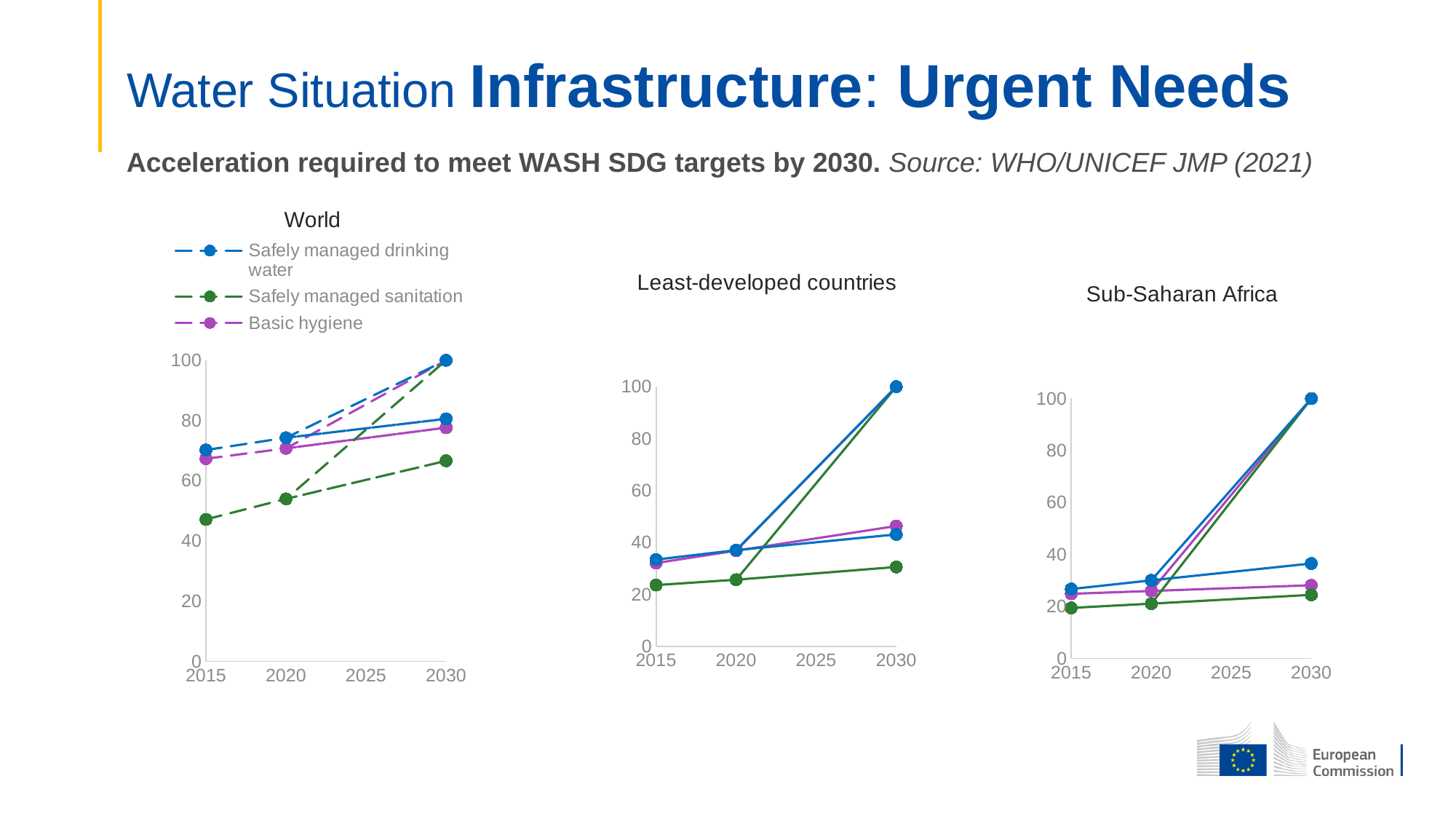
In the Least-developed countries chart, is the value for Safely managed sanitation in 2015 greater or less than 40? less In the Least-developed countries chart, what value do the steeply rising lines reach in 2030? 100 In the World chart, does the Safely managed sanitation line rise or fall from 2015 to 2030? rise What kind of chart is the World chart? line chart In the World chart, which is larger in 2015: Safely managed drinking water or Safely managed sanitation? Safely managed drinking water In the World chart legend, what colour is the Basic hygiene series? purple In the Sub-Saharan Africa chart, is the value for Safely managed sanitation in 2015 greater or less than 40? less In the World chart, is the value for Safely managed sanitation in 2015 greater or less than 60? less In the World chart, what value do the dashed target lines reach in 2030? 100 How many charts are shown on the slide? 3 How many series does the legend of the World chart list? 3